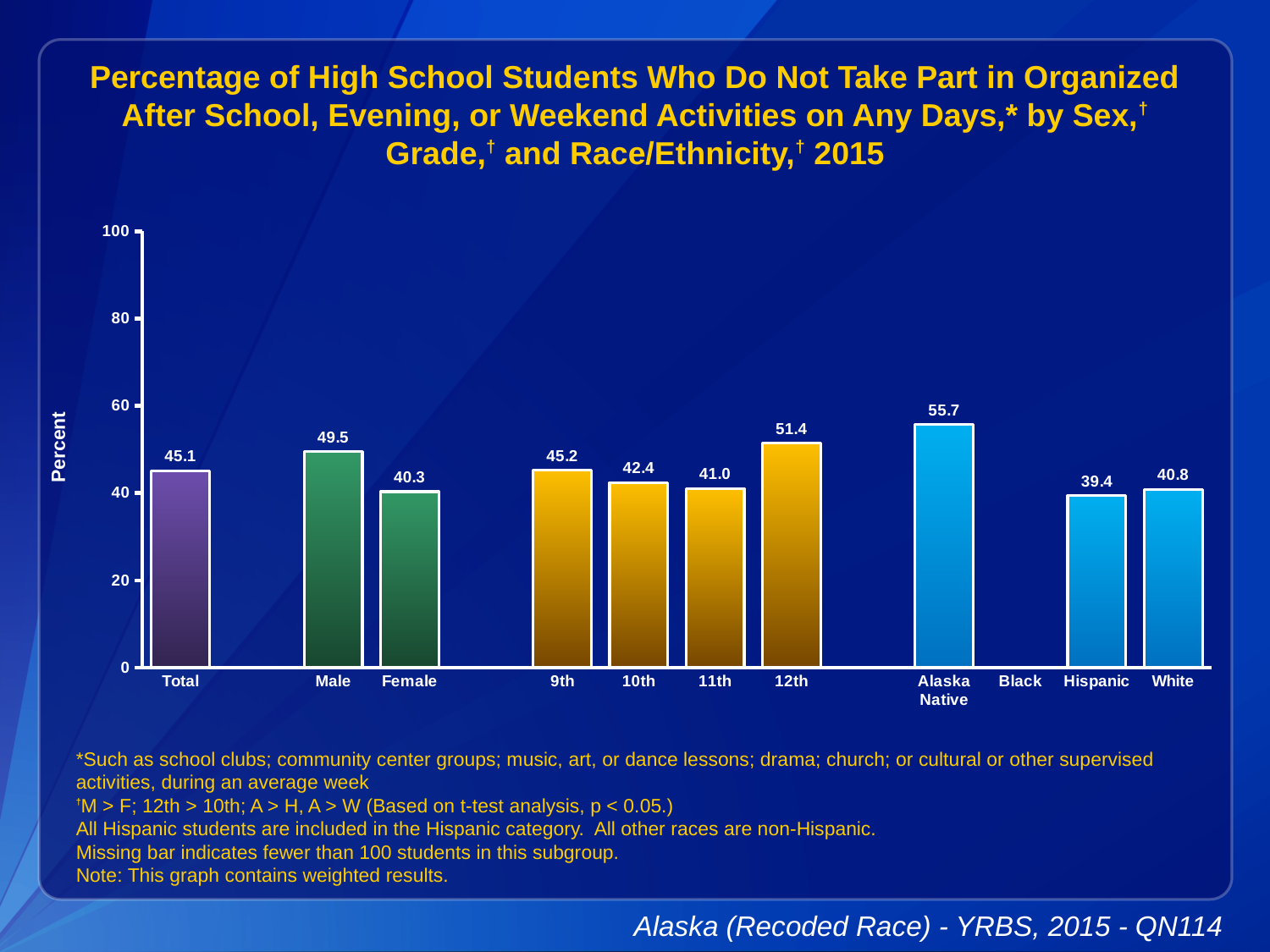
Which is larger, the value for 12th grade or the value for 9th grade? 12th What is the value for Alaska Native? 55.7 Which category has the highest value? Alaska Native Which category has the lowest value? Hispanic What kind of chart is shown? bar chart What is the value for Male? 49.5 Which category label has no bar plotted? Black What is the value for Total? 45.1 What is the value for 10th grade? 42.4 Is the value for Alaska Native greater or less than 60? less What is the difference between the Male and Female values? 9.2 How many bars are plotted on the chart? 10